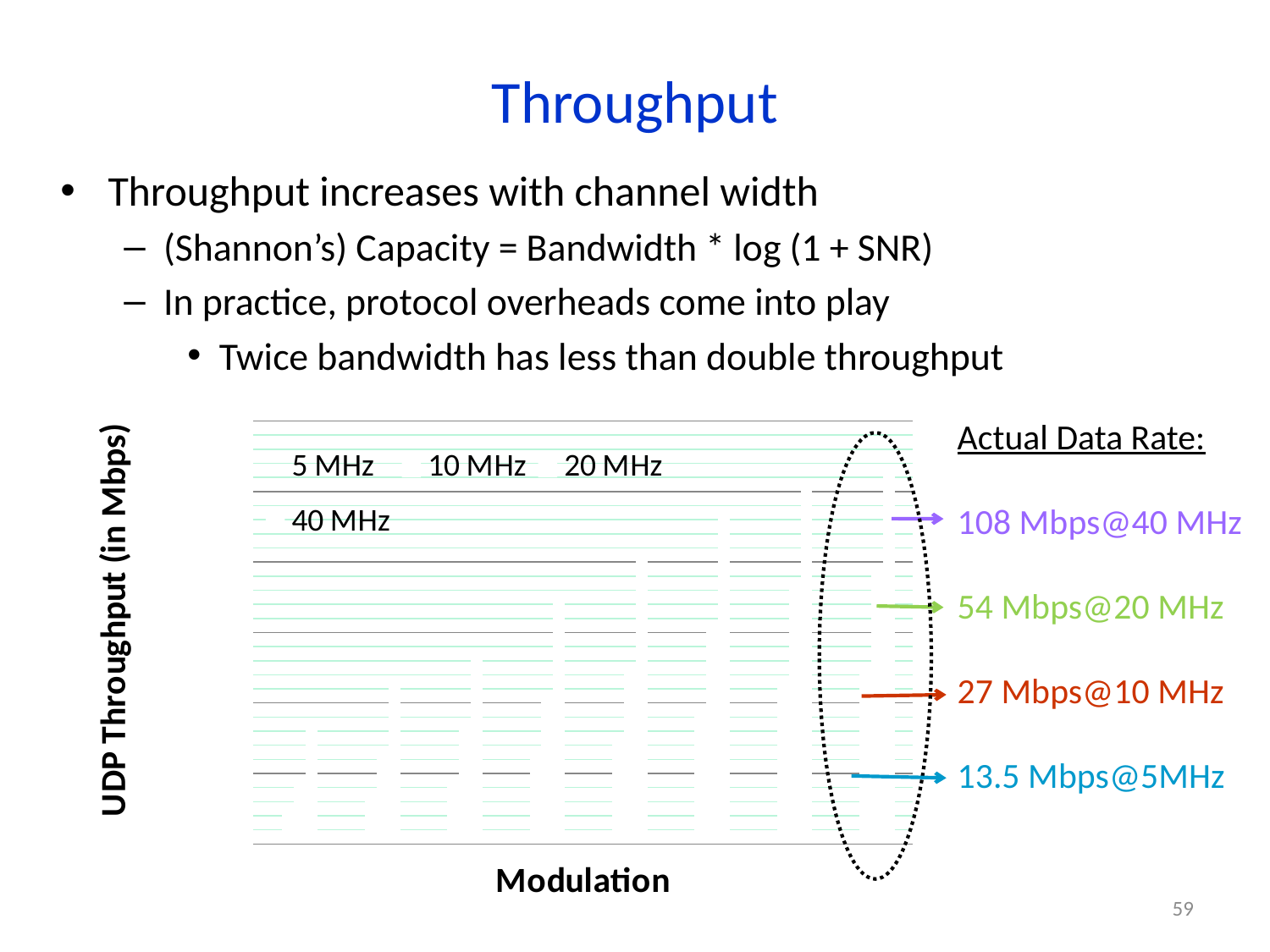
What actual data rate is annotated for the 20 MHz channel width? 54 Mbps What kind of chart is shown on the slide? bar chart Which has the larger annotated actual data rate, 10 MHz or 20 MHz? 20 MHz What actual data rate is annotated for the 5 MHz channel width? 13.5 Mbps What is the difference between the annotated actual data rates at 40 MHz and 20 MHz? 54 Mbps Which channel width has the highest annotated actual data rate? 40 MHz Which channel width has the lowest annotated actual data rate? 5 MHz What is the label of the chart's vertical axis? UDP Throughput (in Mbps) What actual data rate is annotated for the 40 MHz channel width? 108 Mbps What is the label of the chart's horizontal axis? Modulation How many series does the chart's legend list? 4 What actual data rate is annotated for the 10 MHz channel width? 27 Mbps